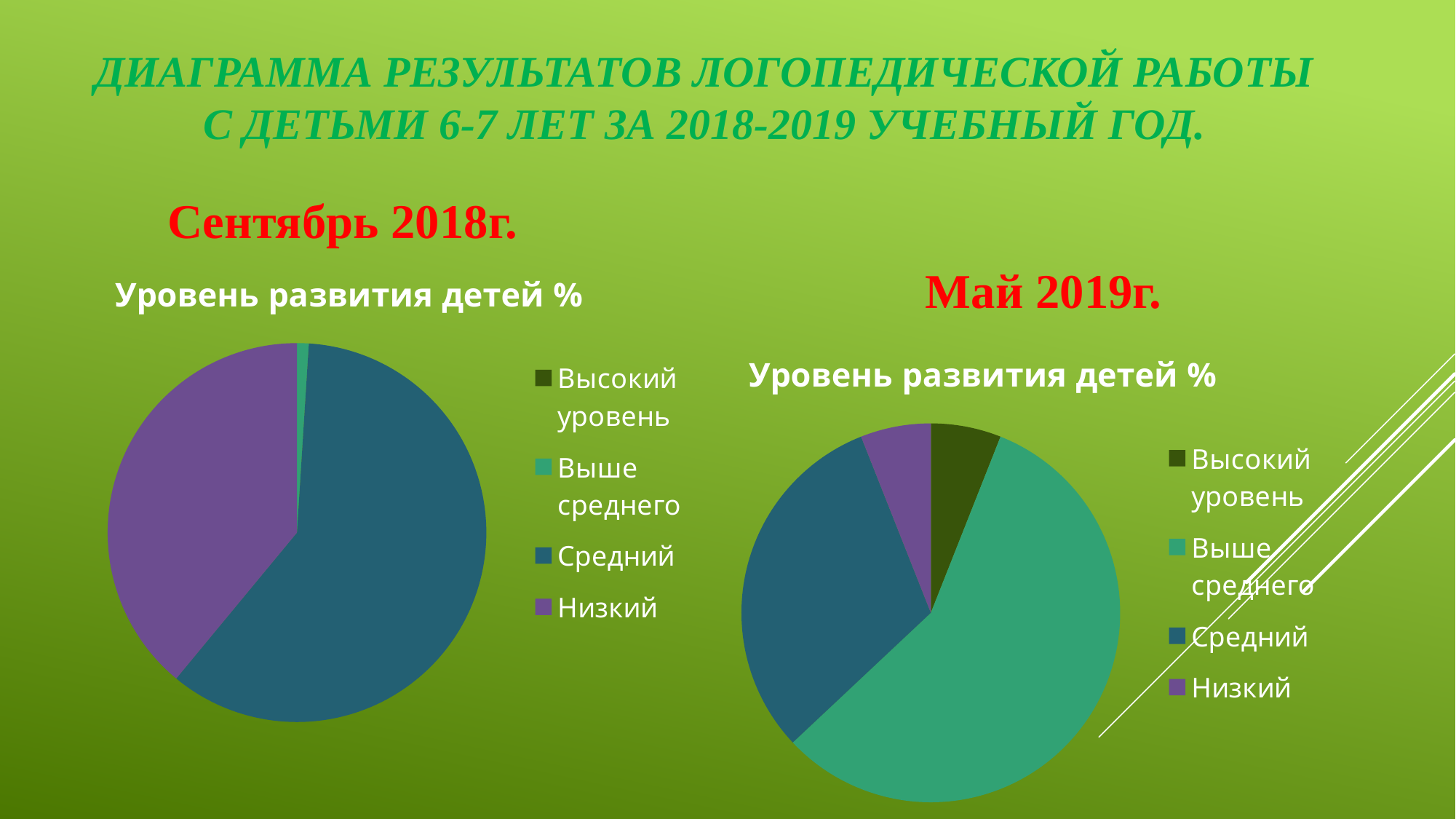
In the Сентябрь 2018г. chart, which is larger: Низкий or Выше среднего? Низкий How many entries does the legend of the Сентябрь 2018г. chart list? 4 What kind of chart is the Май 2019г. chart? pie chart In the Сентябрь 2018г. chart, which is larger: Средний or Низкий? Средний How many entries does the legend of the Май 2019г. chart list? 4 In the Май 2019г. chart, which is larger: Выше среднего or Средний? Выше среднего What is the title of the Май 2019г. chart? Уровень развития детей % What kind of chart is the Сентябрь 2018г. chart? pie chart In the Сентябрь 2018г. chart, what colour is the Низкий slice? purple In the Сентябрь 2018г. chart, which category has the largest slice? Средний In the Май 2019г. chart, which category has the largest slice? Выше среднего